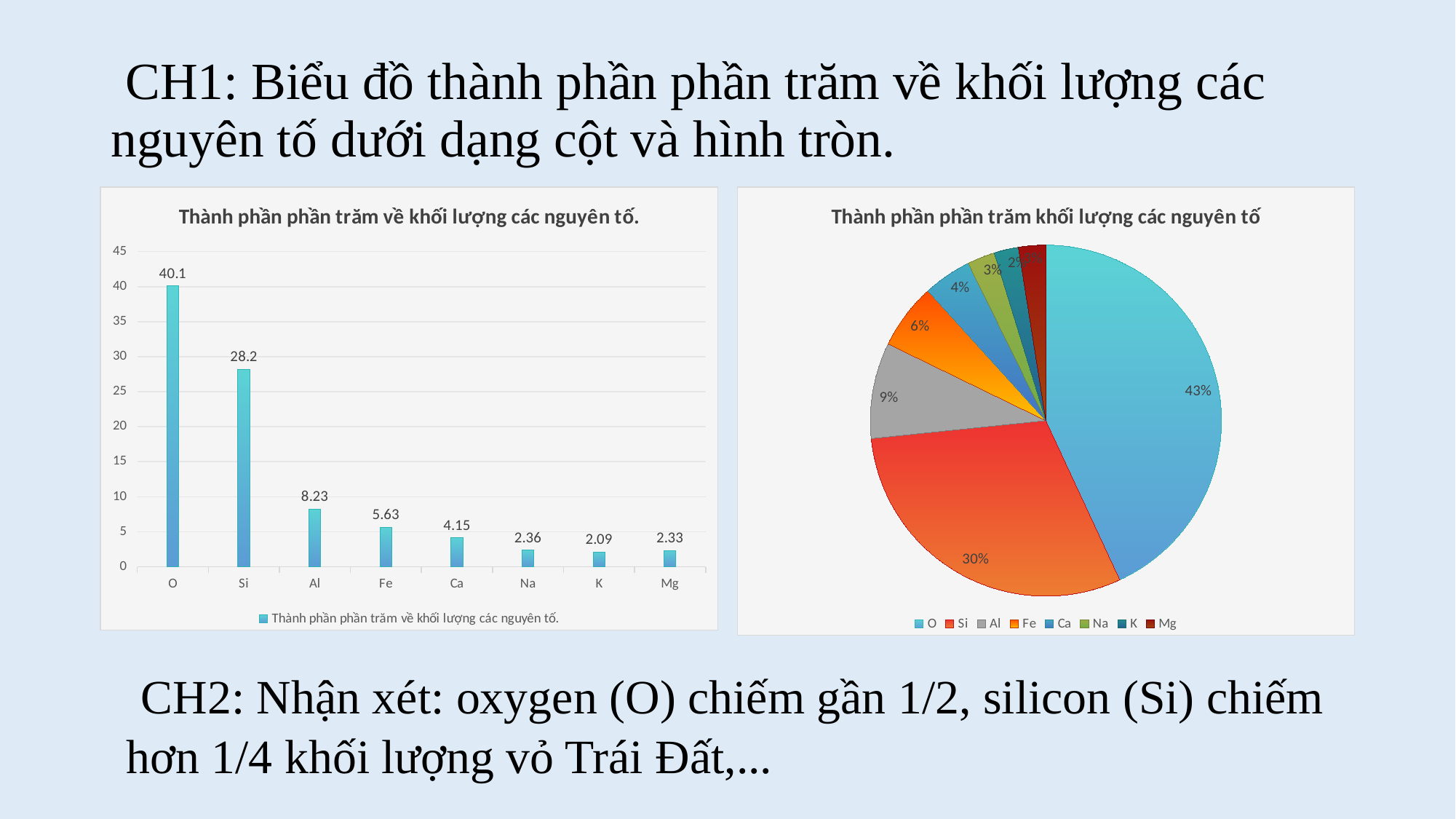
In the bar chart on the left, how many elements are shown on the x axis? 8 In the pie chart on the right, what share does O have? 43% In the bar chart on the left, which element has the highest value? O In the bar chart on the left, what is the value for O? 40.1 In the bar chart on the left, which element has the lowest value? K In the bar chart on the left, what is the difference between the values for O and Si? 11.9 In the bar chart on the left, what is the value for Fe? 5.63 In the pie chart on the right, what share does Si have? 30% How many entries does the legend of the pie chart on the right list? 8 What kind of chart is the chart on the left? Bar chart In the bar chart on the left, what is the value for Al? 8.23 In the bar chart on the left, which is larger, the value for Ca or the value for Na? Ca